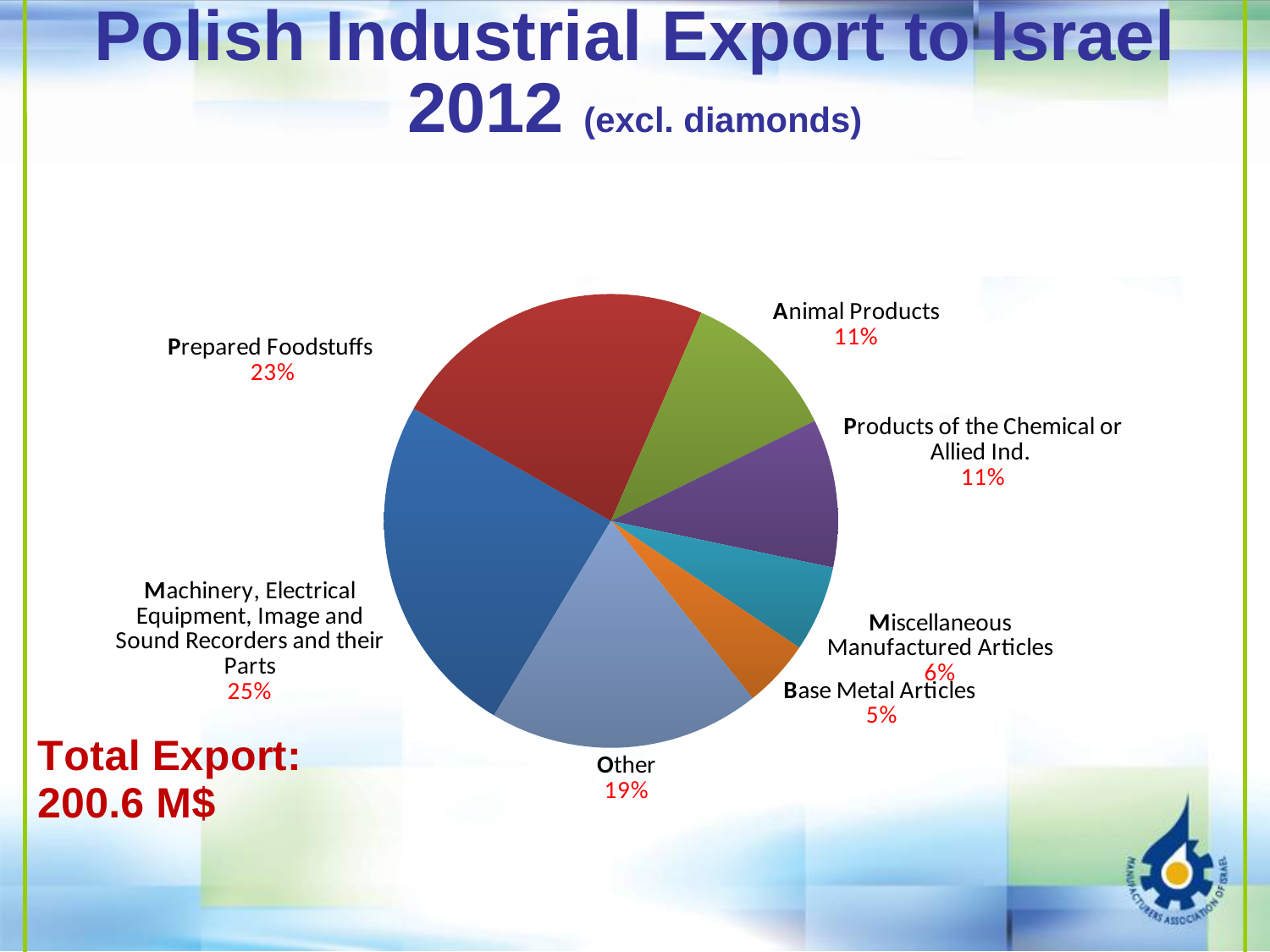
How many categories are shown in the pie chart? 7 What percentage is shown for Base Metal Articles? 5% Which is larger, the share for Miscellaneous Manufactured Articles or the share for Animal Products? Animal Products Which category has the smallest share of the pie? Base Metal Articles What is the combined share of Animal Products and Products of the Chemical or Allied Ind.? 22% What kind of chart is shown on the slide? Pie chart What share of the pie is Machinery, Electrical Equipment, Image and Sound Recorders and their Parts? 25% What share of Polish industrial export to Israel in 2012 is Prepared Foodstuffs? 23% What percentage is shown for Other? 19% What total export value is stated on the slide? 200.6 M$ What is the difference in percentage points between Prepared Foodstuffs and Other? 4 Which category has the largest share of the pie? Machinery, Electrical Equipment, Image and Sound Recorders and their Parts